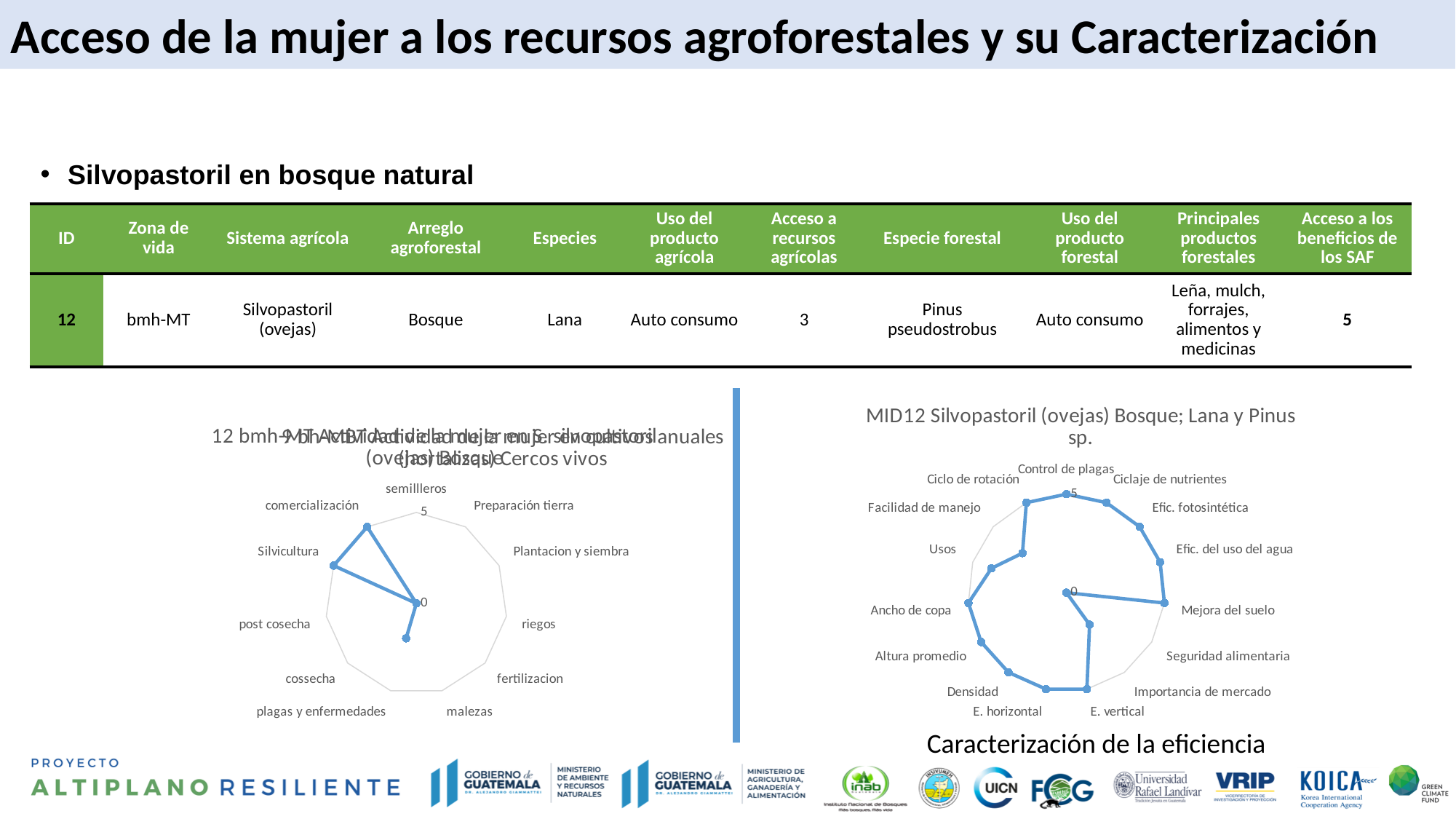
In the left radar chart, which is larger, the value for Silvicultura or the value for post cosecha? Silvicultura In the right chart 'MID12 Silvopastoril (ovejas) Bosque; Lana y Pinus sp.', which is larger, the value for Mejora del suelo or the value for Seguridad alimentaria? Mejora del suelo What kind of chart is the chart on the left of the slide, below the table? Radar chart In the right chart 'MID12 Silvopastoril (ovejas) Bosque; Lana y Pinus sp.', how many categories are plotted around the radar? 15 In the right chart 'MID12 Silvopastoril (ovejas) Bosque; Lana y Pinus sp.', what is the value for Control de plagas? 5 What kind of chart is the chart on the right of the slide, titled 'MID12 Silvopastoril (ovejas) Bosque; Lana y Pinus sp.'? Radar chart In the left radar chart, how many categories are plotted around the radar? 11 In the left radar chart, which is larger, the value for comercialización or the value for riegos? comercialización What is the title of the radar chart on the right of the slide? MID12 Silvopastoril (ovejas) Bosque; Lana y Pinus sp. In the right chart 'MID12 Silvopastoril (ovejas) Bosque; Lana y Pinus sp.', is the value for Seguridad alimentaria greater or less than 5? less What caption appears directly below the right radar chart? Caracterización de la eficiencia